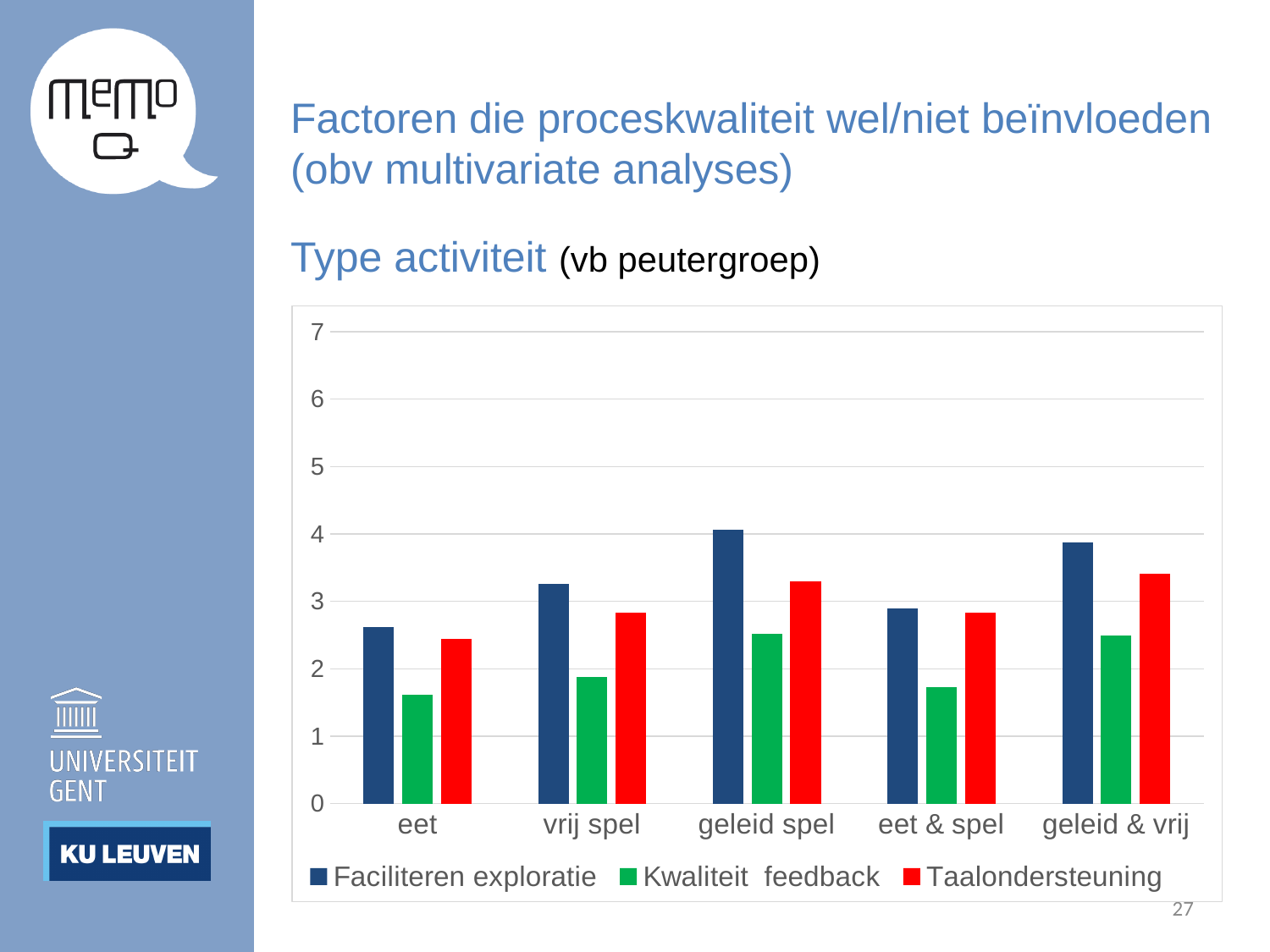
Is the value of Taalondersteuning for eet greater or less than 3? less Is the value of Faciliteren exploratie for vrij spel greater or less than 3? greater What kind of chart is shown on the slide? bar chart Which series is shown in green in the chart? Kwaliteit feedback For the category eet, which is larger: Faciliteren exploratie or Kwaliteit feedback? Faciliteren exploratie Is the value of Taalondersteuning for geleid & vrij greater or less than 3? greater How many activity categories are shown on the x axis of the chart? 5 Which series is shown in red in the chart? Taalondersteuning How many series does the chart's legend list? 3 Which is larger: Taalondersteuning for geleid spel or Taalondersteuning for eet? geleid spel